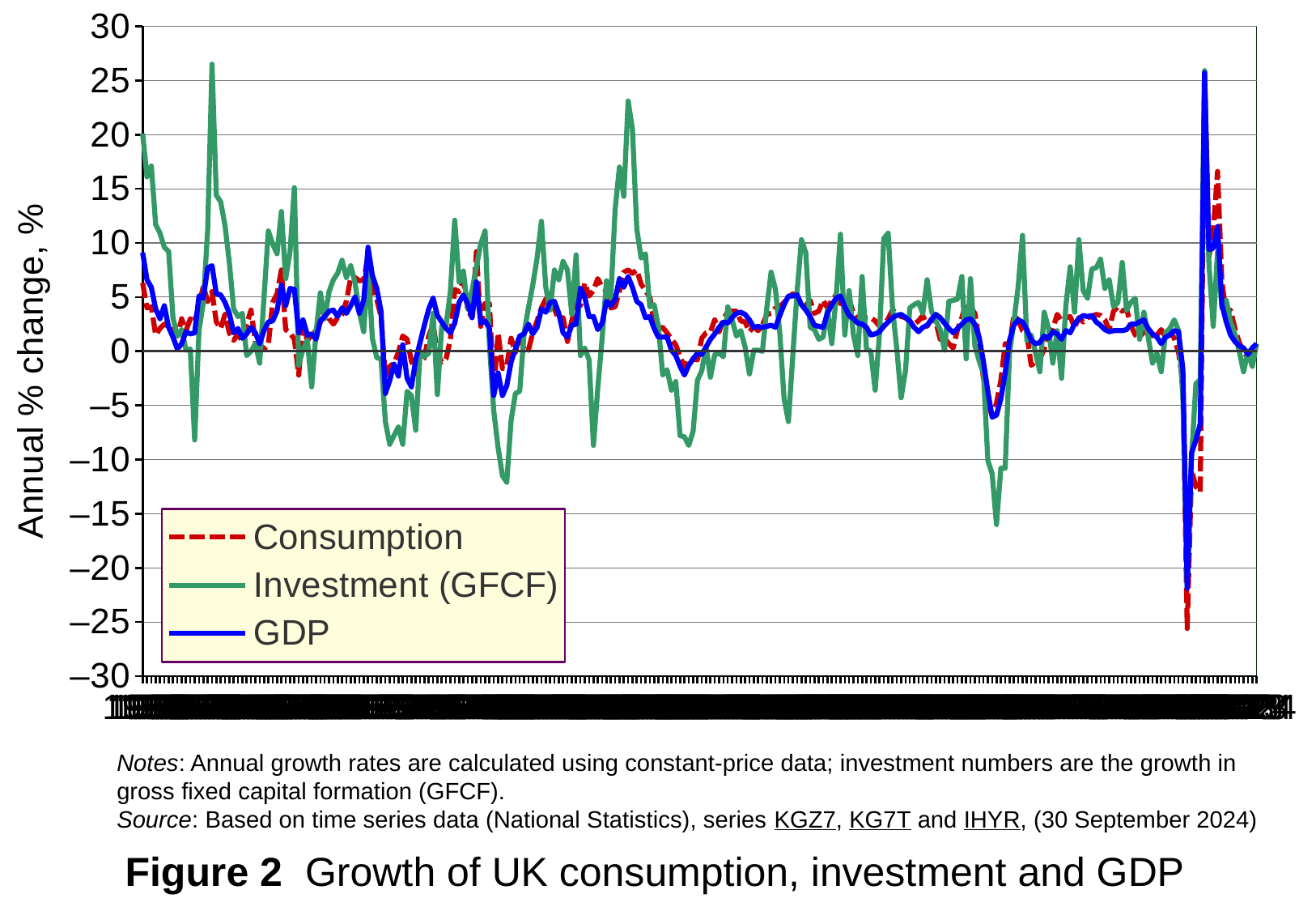
What is the minimum value shown on the y-axis? -30 Is the highest value reached by the Investment (GFCF) series greater or less than 20? greater What is the title of the y-axis? Annual % change, % Which series reaches the lowest value on the chart? Consumption Is the lowest value reached by the GDP series greater or less than -20? less What kind of chart is shown on the slide? Line chart What is the maximum value shown on the y-axis? 30 Is the lowest value reached by the Investment (GFCF) series greater or less than -10? less What are the three series named in the legend? Consumption, Investment (GFCF), GDP How many series does the legend list? 3